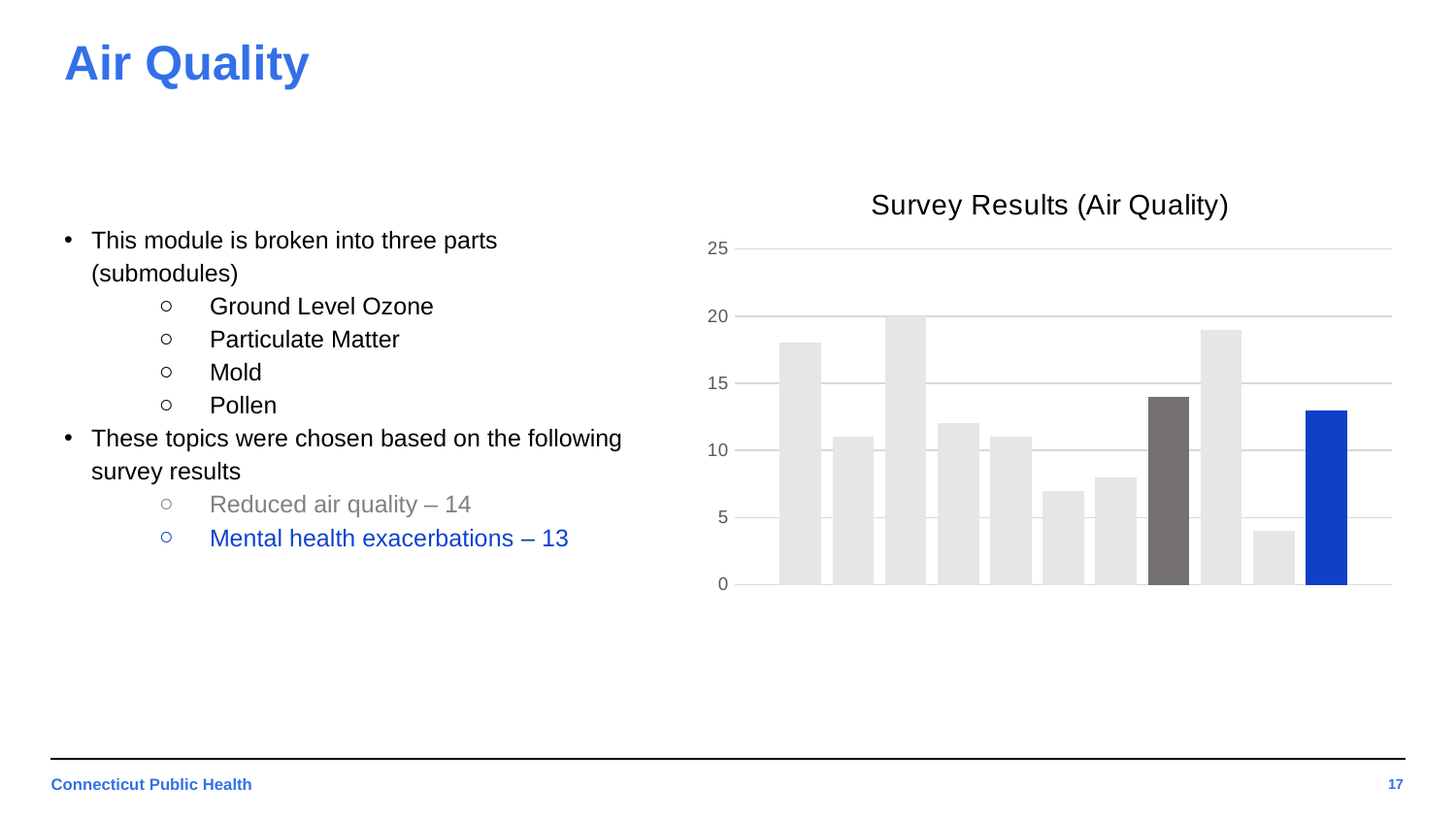
Is the value of the first bar from the left greater or less than 15? greater Which bar is the tallest in the chart? the third bar from the left What type of chart is shown on the slide? bar chart Is the value of the dark gray bar greater or less than 15? less What is the highest value shown on the vertical axis? 25 What is the value of the third bar from the left, the tallest bar? 20 How many bars are plotted in the chart? 11 Which bar is the shortest in the chart? the tenth bar from the left What is the title of the chart? Survey Results (Air Quality) Is the value of the blue bar greater or less than 10? greater Which is taller, the dark gray bar or the blue bar? the dark gray bar